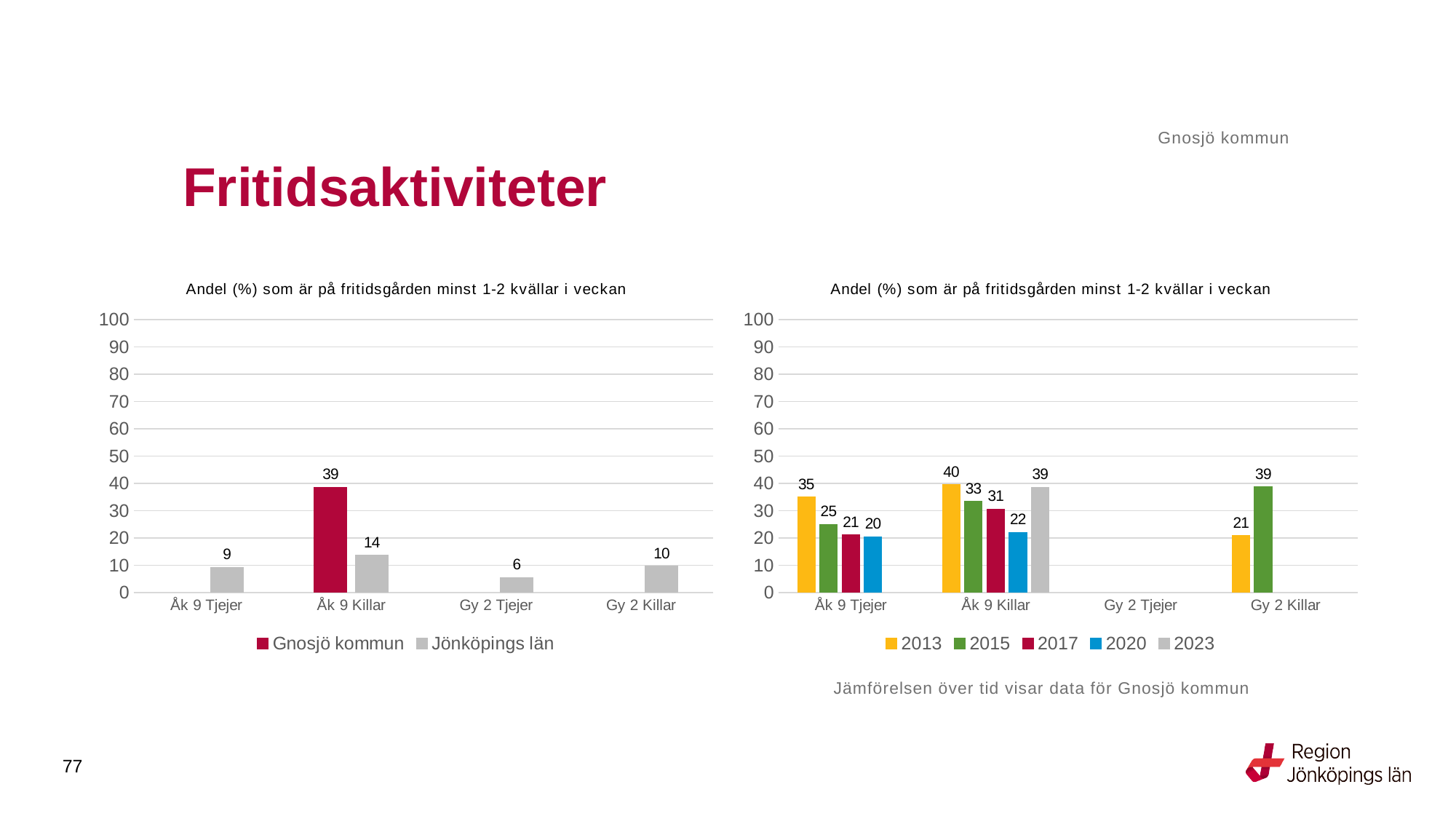
In the right chart, what is the value for 2023 for Åk 9 Killar? 39 In the left chart, what is the value for Jönköpings län for Åk 9 Killar? 14 In the left chart, what is the difference between Gnosjö kommun and Jönköpings län for Åk 9 Killar? 25 In the right chart, which is larger for Gy 2 Killar: 2013 or 2015? 2015 In the right chart, what is the value for 2013 for Åk 9 Tjejer? 35 In the right chart, what is the difference between the 2013 and 2020 values for Åk 9 Tjejer? 15 In the right chart, which year has the highest value for Åk 9 Killar? 2013 In the right chart, how many series does the legend list? 5 What kind of chart is the right chart? Bar chart In the left chart, how many series does the legend list? 2 In the left chart, what is the value for Gnosjö kommun for Åk 9 Killar? 39 In the left chart, which category has the lowest value for Jönköpings län? Gy 2 Tjejer